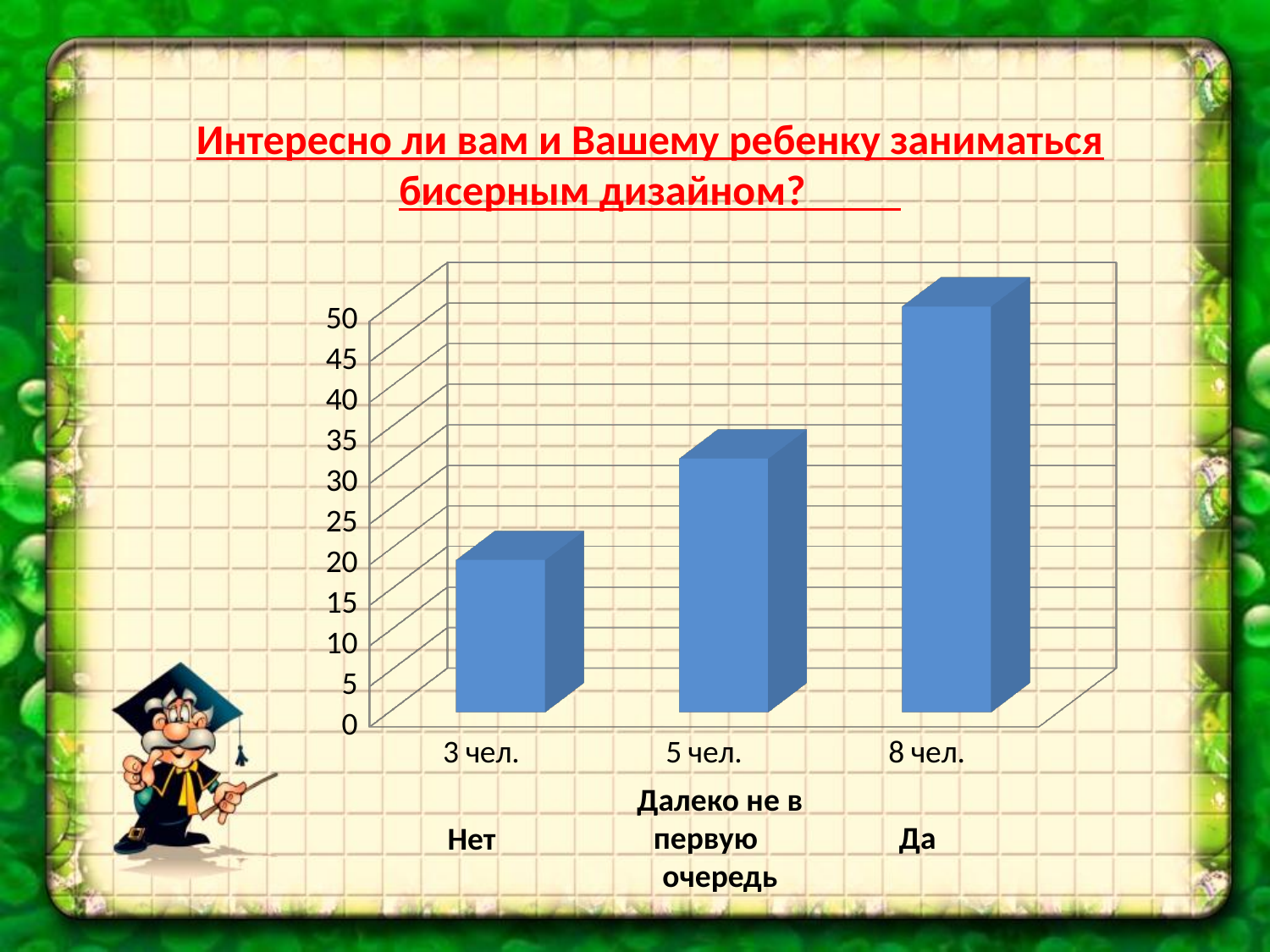
Do the bar values rise or fall from left to right along the x axis? rise Which category has the lowest bar? Нет (3 чел.) Is the value for "Далеко не в первую очередь" greater or less than 40? less Which is larger, the bar for "Нет" or the bar for "Далеко не в первую очередь"? Далеко не в первую очередь What is the title of the chart on the slide? Интересно ли вам и Вашему ребенку заниматься бисерным дизайном? Is the value for "Далеко не в первую очередь" greater or less than 25? greater What is the highest value shown on the vertical axis? 50 Which category has the highest bar? Да (8 чел.) Is the value for "Да" greater or less than 45? greater What kind of chart is shown on the slide? bar chart How many bars does the chart have? 3